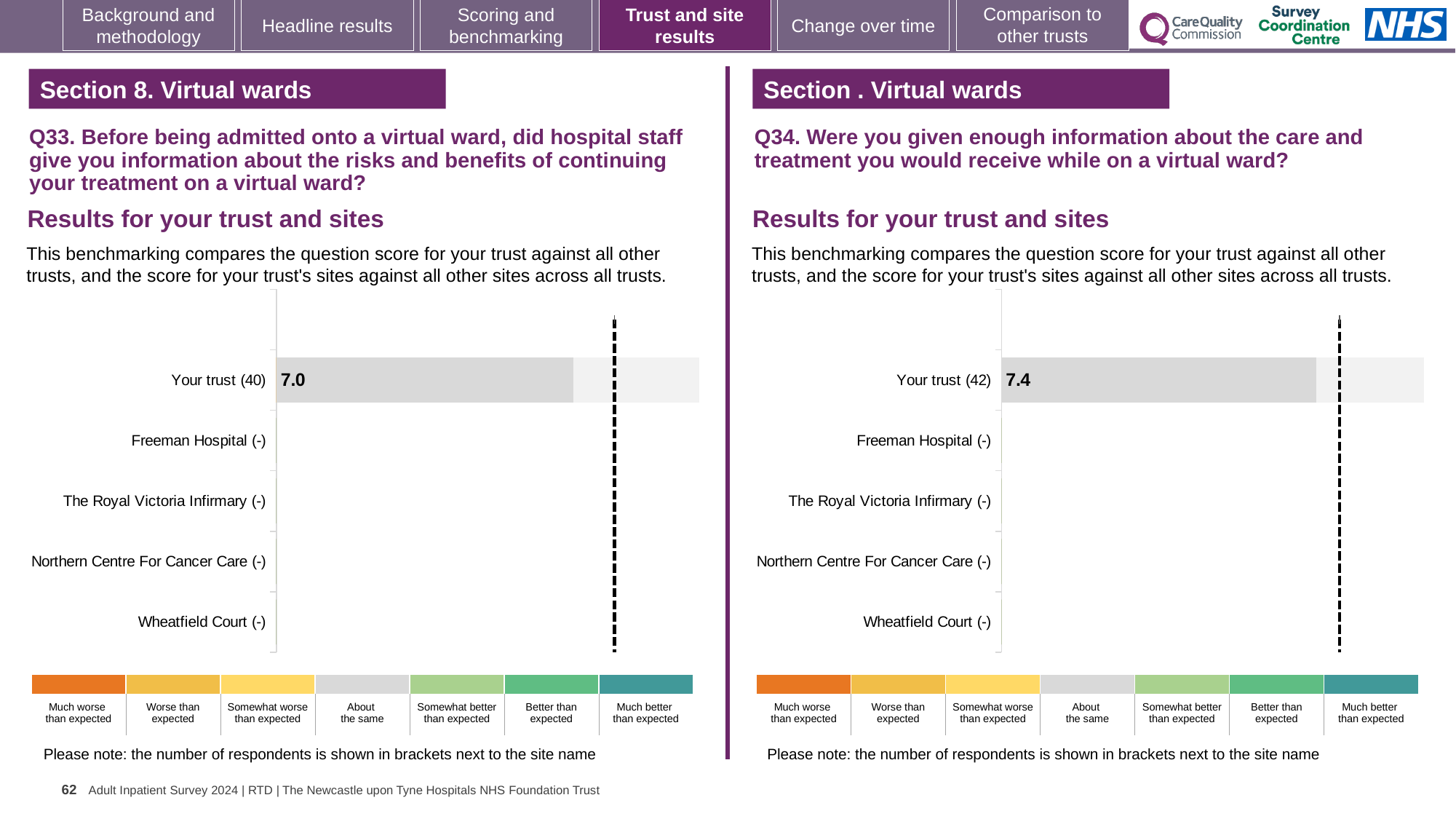
How many categories (rows) are listed on the Q33 chart (left)? 5 On the Q34 chart (right), what is the score for Your trust? 7.4 Which is larger: the Your trust score on the Q33 chart (left) or the Your trust score on the Q34 chart (right)? Q34 chart (right) What kind of chart is the Q33 chart (left)? Bar chart How many benchmark categories does the legend below the Q34 chart (right) list? 7 On the Q34 chart (right), what is the last site listed below Your trust? Wheatfield Court (-) How many categories (rows) are listed on the Q34 chart (right)? 5 On the Q34 chart (right), how many respondents are shown in brackets next to Your trust? 42 On the Q33 chart (left), which category has a plotted bar? Your trust (40) What is the difference between the Your trust score on the Q34 chart (right) and the Your trust score on the Q33 chart (left)? 0.4 On the Q33 chart (left), how many respondents are shown in brackets next to Your trust? 40 On the Q33 chart (left), what is the score for Your trust? 7.0